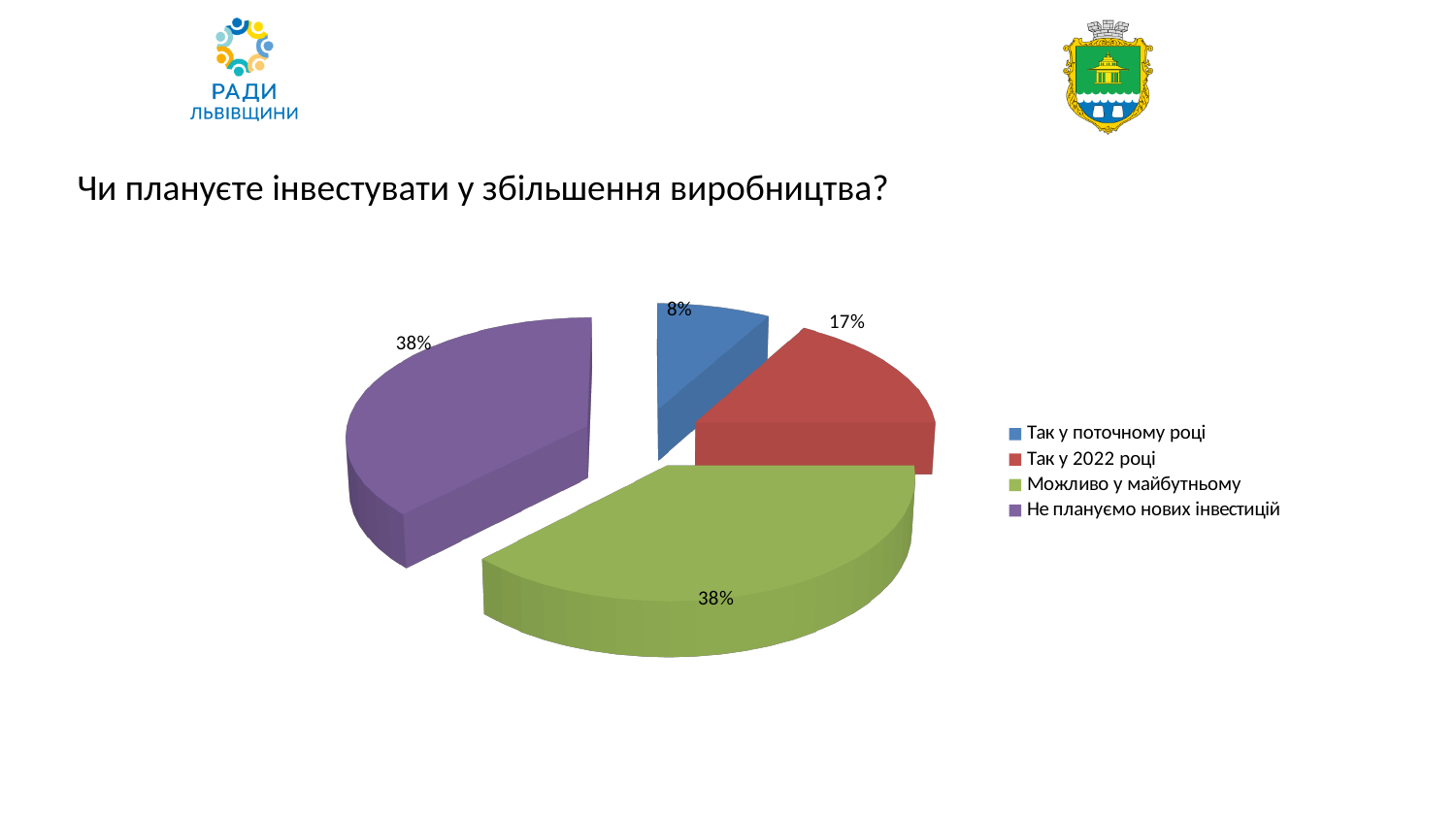
What is the title of the chart on the slide? Чи плануєте інвестувати у збільшення виробництва? What kind of chart is shown on the slide? Pie chart By how many percentage points does "Можливо у майбутньому" exceed "Так у 2022 році"? 21 percentage points What share of the pie does "Можливо у майбутньому" represent? 38% Which is larger: the slice for "Так у 2022 році" or the slice for "Так у поточному році"? Так у 2022 році By how many percentage points does "Так у 2022 році" exceed "Так у поточному році"? 9 percentage points Which category has the smallest slice of the pie? Так у поточному році What share of the pie does "Не плануємо нових інвестицій" represent? 38% How many categories does the pie chart have? 4 What share of the pie does "Так у поточному році" represent? 8% Which colour represents "Не плануємо нових інвестицій" in the legend? Purple